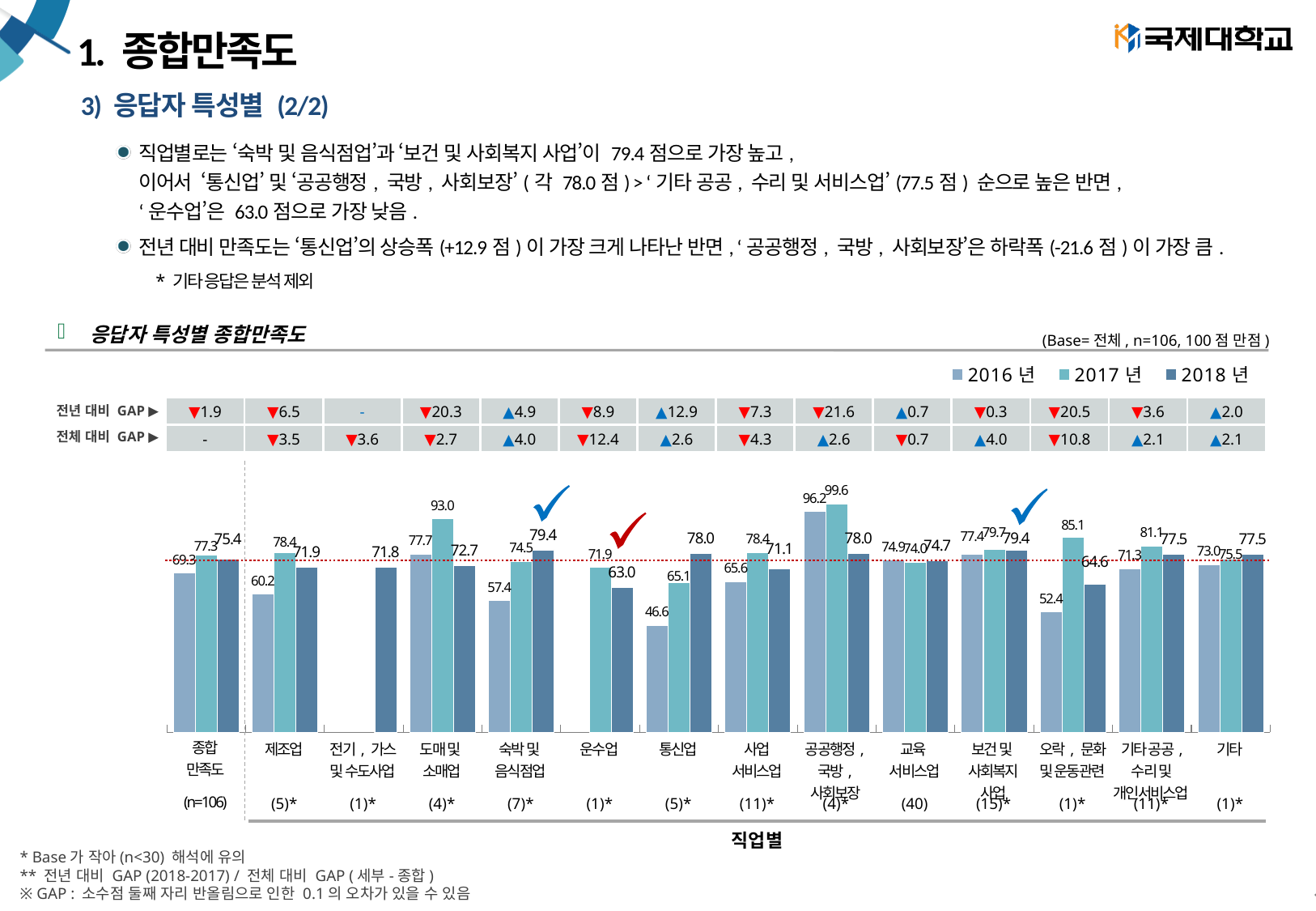
How many categories are shown along the x axis of the chart? 14 How many series does the chart legend list? 3 Which is larger, the 2017년 value for 오락, 문화 및 운동관련 or the 2017년 value for 기타공공, 수리 및 개인서비스업? 오락, 문화 및 운동관련 What kind of chart is shown on the slide? bar chart What is the difference between the 2017년 and 2018년 values for 공공행정, 국방, 사회보장? 21.6 What is the title of the chart? 응답자 특성별 종합만족도 Do the values for 통신업 rise or fall from 2016년 to 2018년? rise Which category has the highest 2017년 value? 공공행정, 국방, 사회보장 What is the 2017년 value for 도매 및 소매업? 93.0 What is the 2016년 value for 통신업? 46.6 Which category has the lowest 2016년 value? 통신업 What is the 2018년 value for 숙박 및 음식점업? 79.4